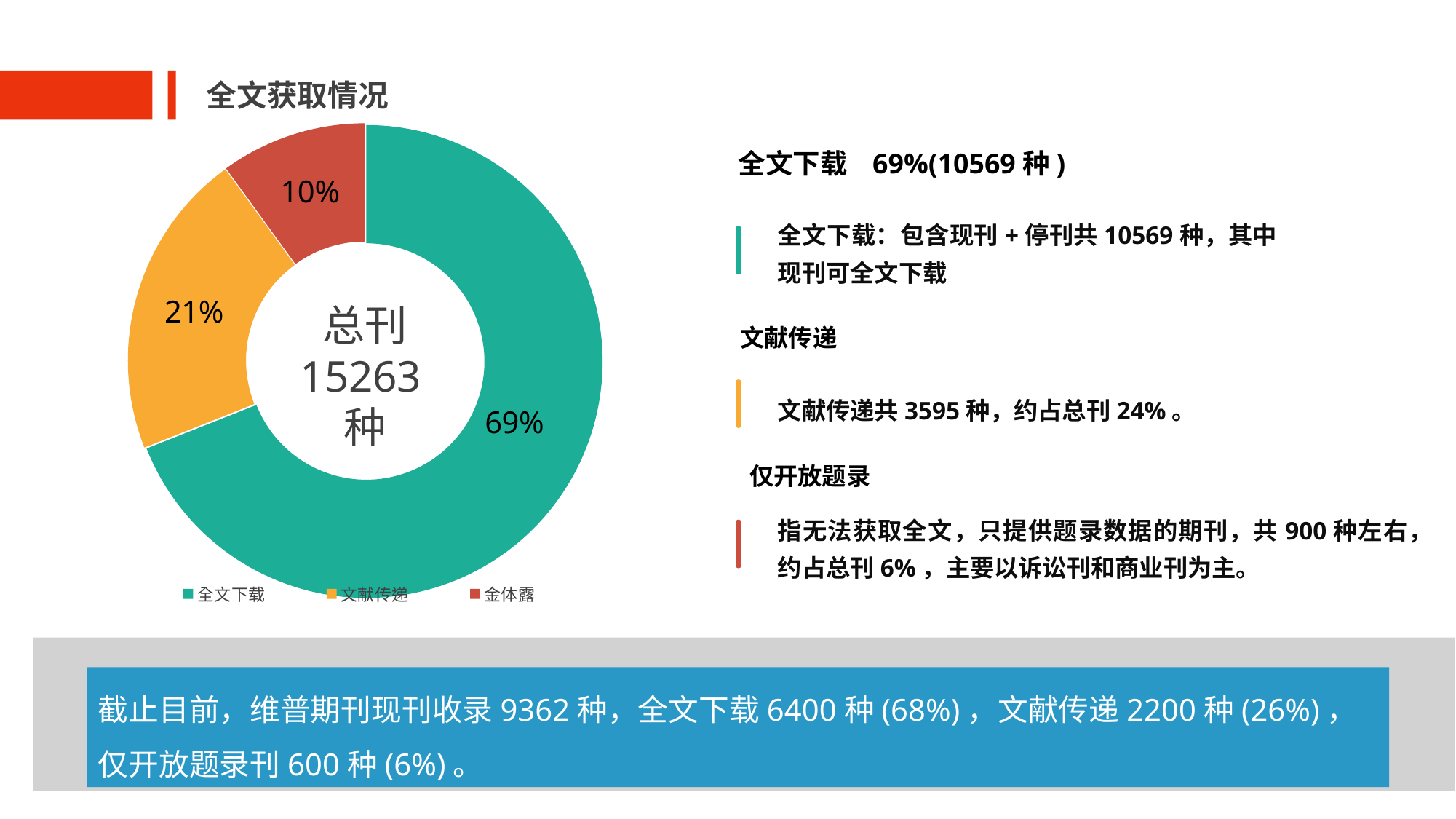
How many entries does the chart legend list? 3 What is the difference in percentage points between the 全文下载 slice and the 文献传递 slice? 48 What percentage does the 文献传递 slice show? 21% Which slice is larger, 文献传递 or 金体露? 文献传递 What kind of chart is shown on the slide? Donut (pie) chart What percentage does the 全文下载 slice show? 69% How many slices does the chart have? 3 What colour is the 全文下载 slice in the chart? Teal (green) Which category has the smallest slice in the chart? 金体露 Which category has the largest slice in the chart? 全文下载 What percentage does the 金体露 slice show? 10% What total is printed in the centre of the donut chart? 总刊 15263 种